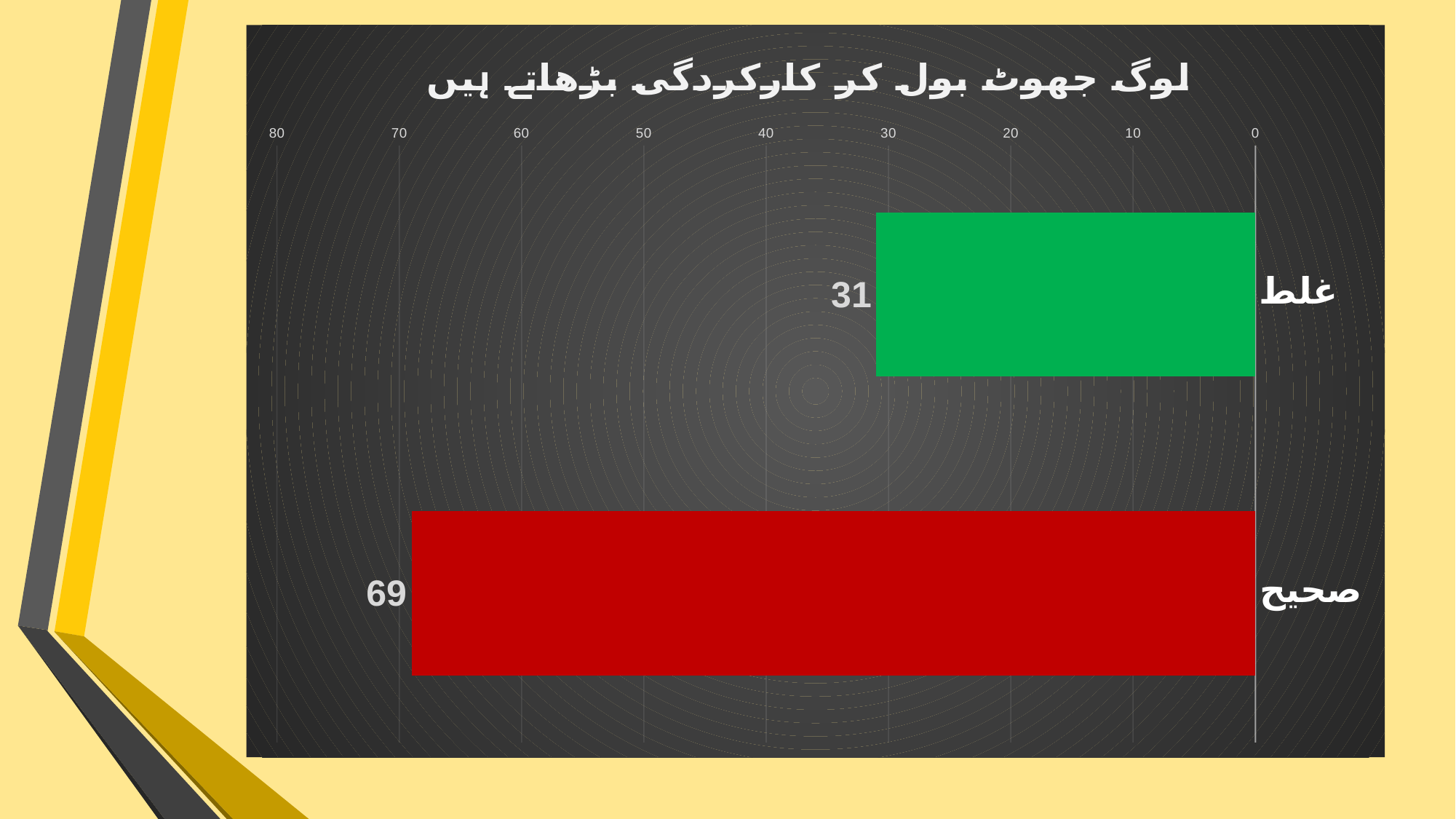
What is the value for غلط? 31 Which category has the highest value? صحیح Which is larger, the value for غلط or the value for صحیح? صحیح Is the value for غلط greater or less than 40? less What is the title of the chart? لوگ جھوٹ بول کر کارکردگی بڑھاتے ہیں Is the value for صحیح greater or less than 60? greater How many categories are shown in the chart? 2 What colour is the bar for صحیح? red What kind of chart is shown on the slide? bar chart What is the value for صحیح? 69 What is the difference between the values for صحیح and غلط? 38 Which category has the lowest value? غلط